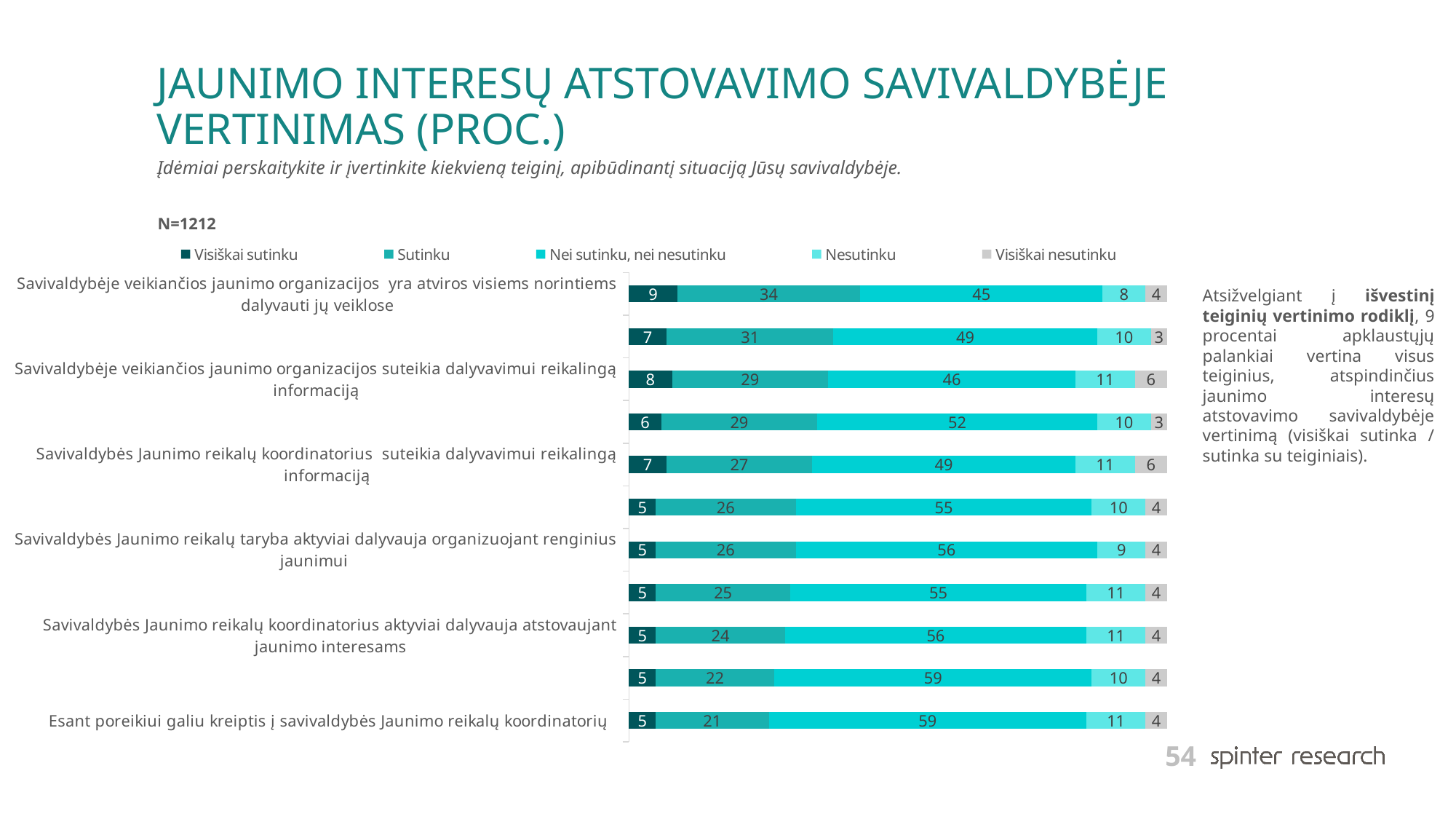
What kind of chart is shown on the slide? Stacked bar chart What is the value of "Visiškai sutinku" for the statement "Savivaldybėje veikiančios jaunimo organizacijos yra atviros visiems norintiems dalyvauti jų veiklose"? 9 What is the value of "Nei sutinku, nei nesutinku" for the statement "Esant poreikiui galiu kreiptis į savivaldybės Jaunimo reikalų koordinatorių"? 59 Which labelled statement has the highest "Visiškai sutinku" value? Savivaldybėje veikiančios jaunimo organizacijos yra atviros visiems norintiems dalyvauti jų veiklose What is the total of the stacked bar for "Savivaldybėje veikiančios jaunimo organizacijos yra atviros visiems norintiems dalyvauti jų veiklose"? 100 What is the difference in the "Sutinku" value between "Savivaldybėje veikiančios jaunimo organizacijos yra atviros visiems norintiems dalyvauti jų veiklose" and "Esant poreikiui galiu kreiptis į savivaldybės Jaunimo reikalų koordinatorių"? 13 How many bars (statements) are plotted in the chart? 11 What sample size (N) is shown above the chart? N=1212 What is the value of "Visiškai nesutinku" for the statement "Savivaldybės Jaunimo reikalų taryba aktyviai dalyvauja organizuojant renginius jaunimui"? 4 Which has the larger "Nesutinku" value: "Savivaldybėje veikiančios jaunimo organizacijos suteikia dalyvavimui reikalingą informaciją" or "Savivaldybėje veikiančios jaunimo organizacijos yra atviros visiems norintiems dalyvauti jų veiklose"? Savivaldybėje veikiančios jaunimo organizacijos suteikia dalyvavimui reikalingą informaciją How many series does the legend list? 5 What is the value of "Sutinku" for the statement "Savivaldybės Jaunimo reikalų koordinatorius suteikia dalyvavimui reikalingą informaciją"? 27